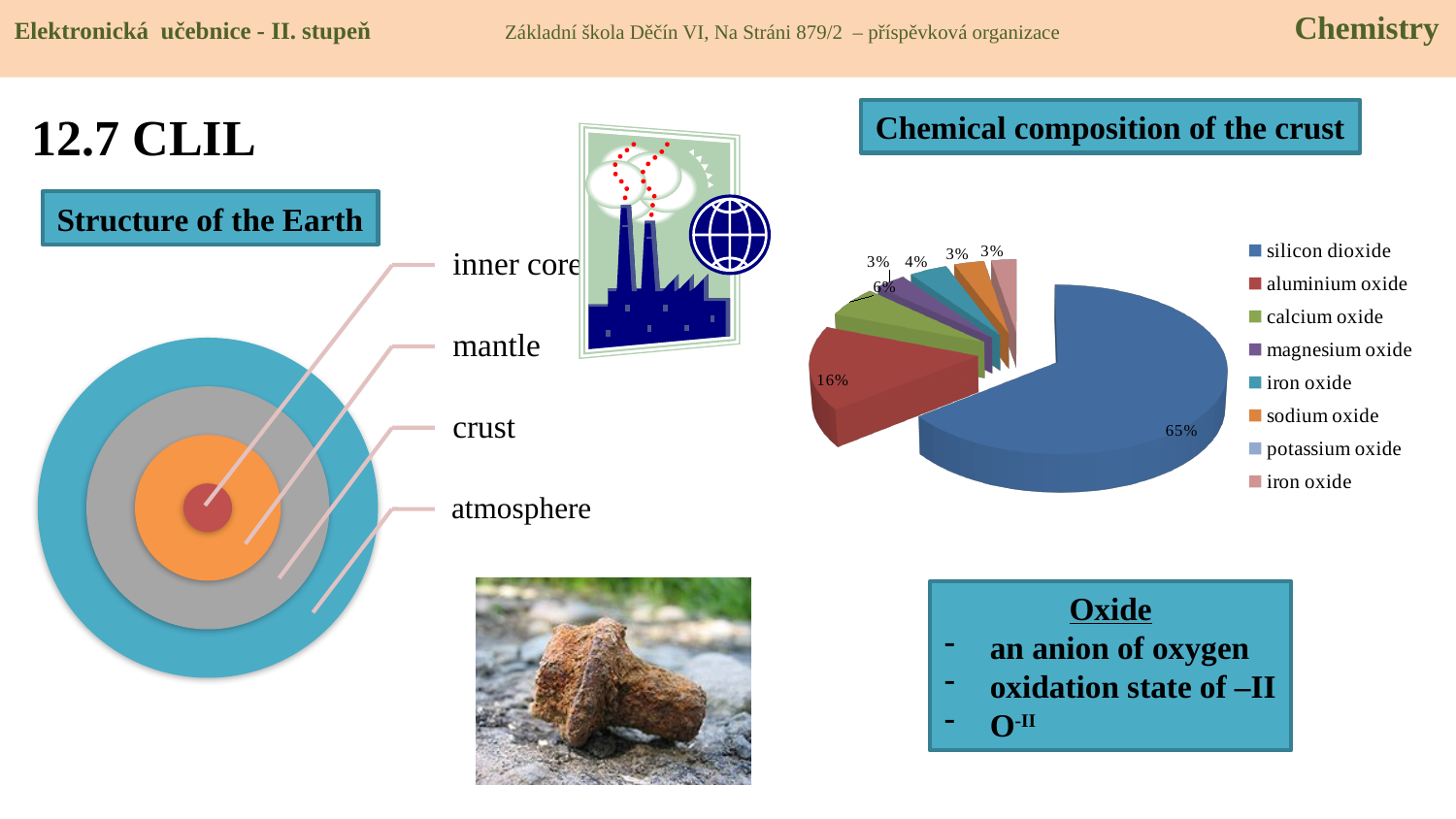
How many entries does the legend of the "Chemical composition of the crust" chart list? 8 In the "Chemical composition of the crust" chart, which has the larger share, silicon dioxide or aluminium oxide? silicon dioxide In the "Chemical composition of the crust" chart, which has the larger share, aluminium oxide or calcium oxide? aluminium oxide In the "Chemical composition of the crust" chart, what percentage is shown for calcium oxide? 6% What kind of chart is shown under the title "Chemical composition of the crust"? pie chart In the "Chemical composition of the crust" chart, what percentage is shown for silicon dioxide? 65% In the "Chemical composition of the crust" chart, what percentage is shown for aluminium oxide? 16% In the "Chemical composition of the crust" chart, what colour is the silicon dioxide slice? blue What is the title of the pie chart on the slide? Chemical composition of the crust What share of the pie in the "Chemical composition of the crust" chart does silicon dioxide take? 65% In the "Chemical composition of the crust" chart, what is the difference in percentage points between silicon dioxide and aluminium oxide? 49 percentage points In the "Chemical composition of the crust" chart, which component has the largest share? silicon dioxide